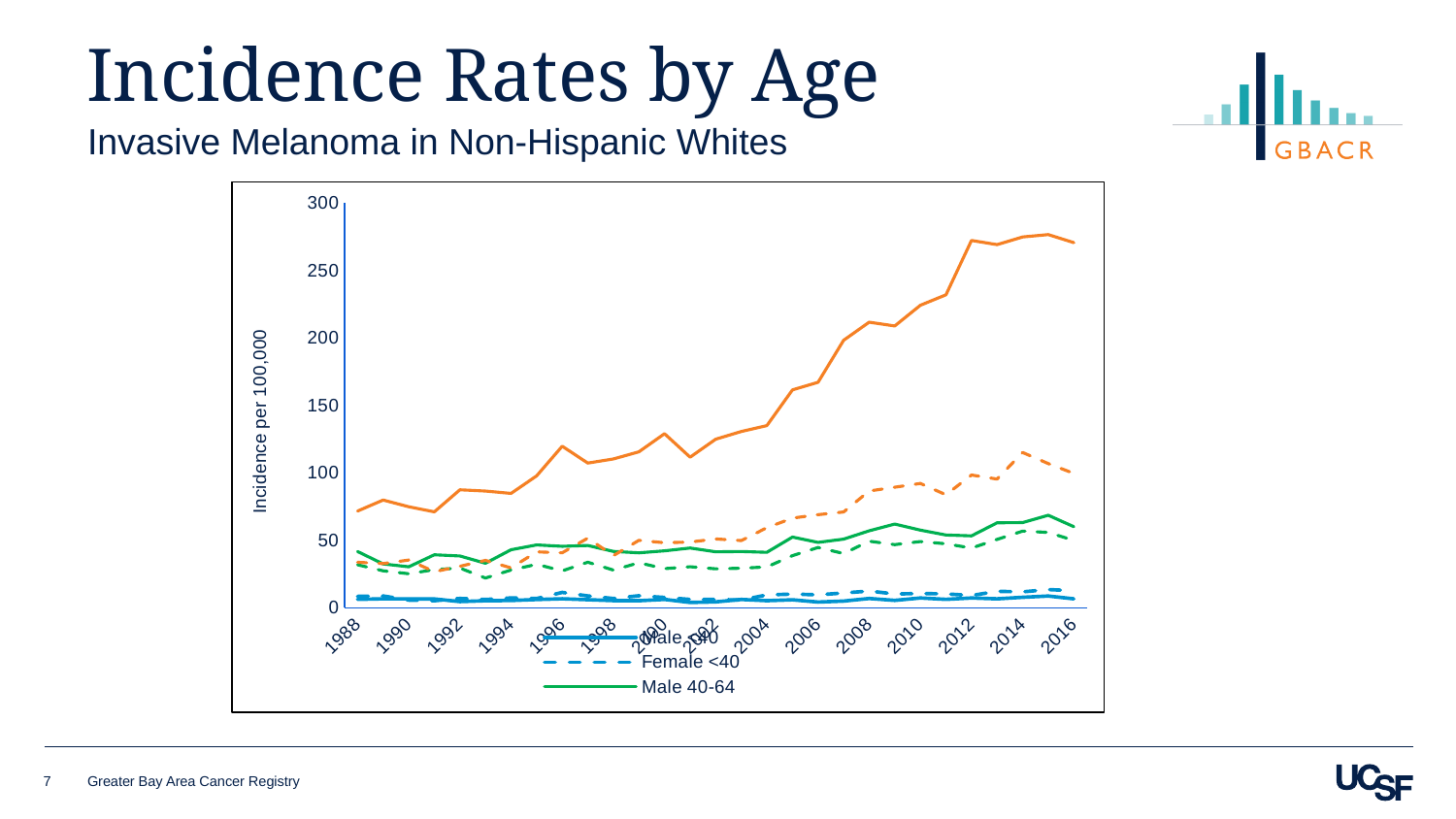
What is the highest tick value shown on the y axis? 300 Is the value for Male 40-64 in 2016 greater or less than 50? greater What is the title of the slide containing the chart? Incidence Rates by Age Does the Male 40-64 series rise or fall overall from 1988 to 2016? rise Which is larger in 2016, the value for Male 40-64 or the value for Female <40? Male 40-64 Is the value for Male 40-64 in 1988 greater or less than 50? less How many year labels are shown on the x axis? 15 Is the value for Male <40 in 2010 greater or less than 50? less What kind of chart is shown on the slide? line chart Which is larger in 2010, the value for Male 40-64 or the value for Male <40? Male 40-64 What is the label on the y axis of the chart? Incidence per 100,000